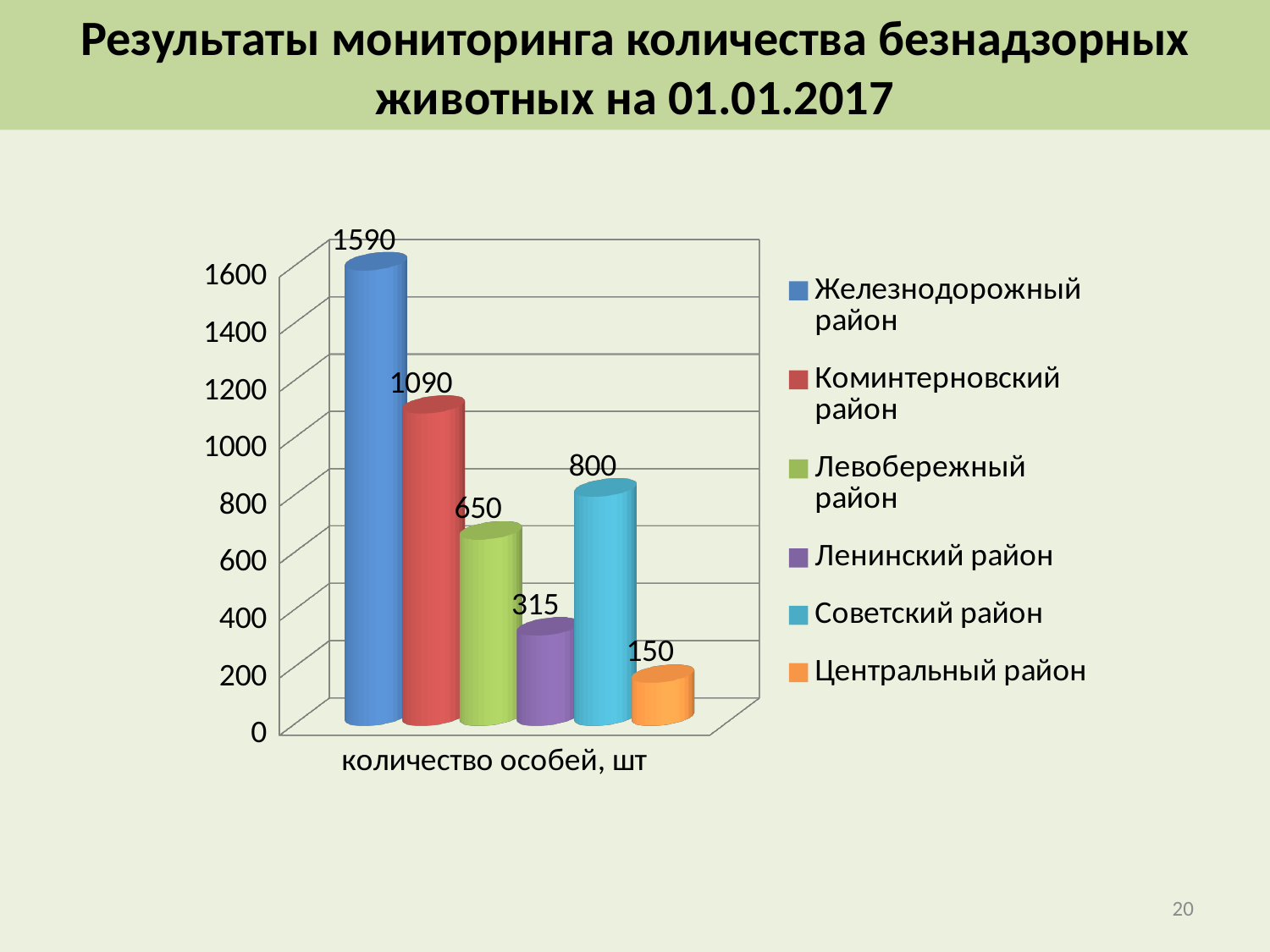
Which is larger, the value for Советский район or the value for Левобережный район? Советский район Which district has the highest value? Железнодорожный район How many series does the legend list? 6 Which district has the lowest value? Центральный район What is the difference between the values for Железнодорожный район and Коминтерновский район? 500 What is the value for Советский район? 800 What is the label on the x axis of the chart? количество особей, шт What kind of chart is shown on the slide? bar chart What is the value for Ленинский район? 315 What is the difference between the values for Левобережный район and Центральный район? 500 Is the value for Коминтерновский район greater or less than 1000? greater What is the value for Железнодорожный район? 1590